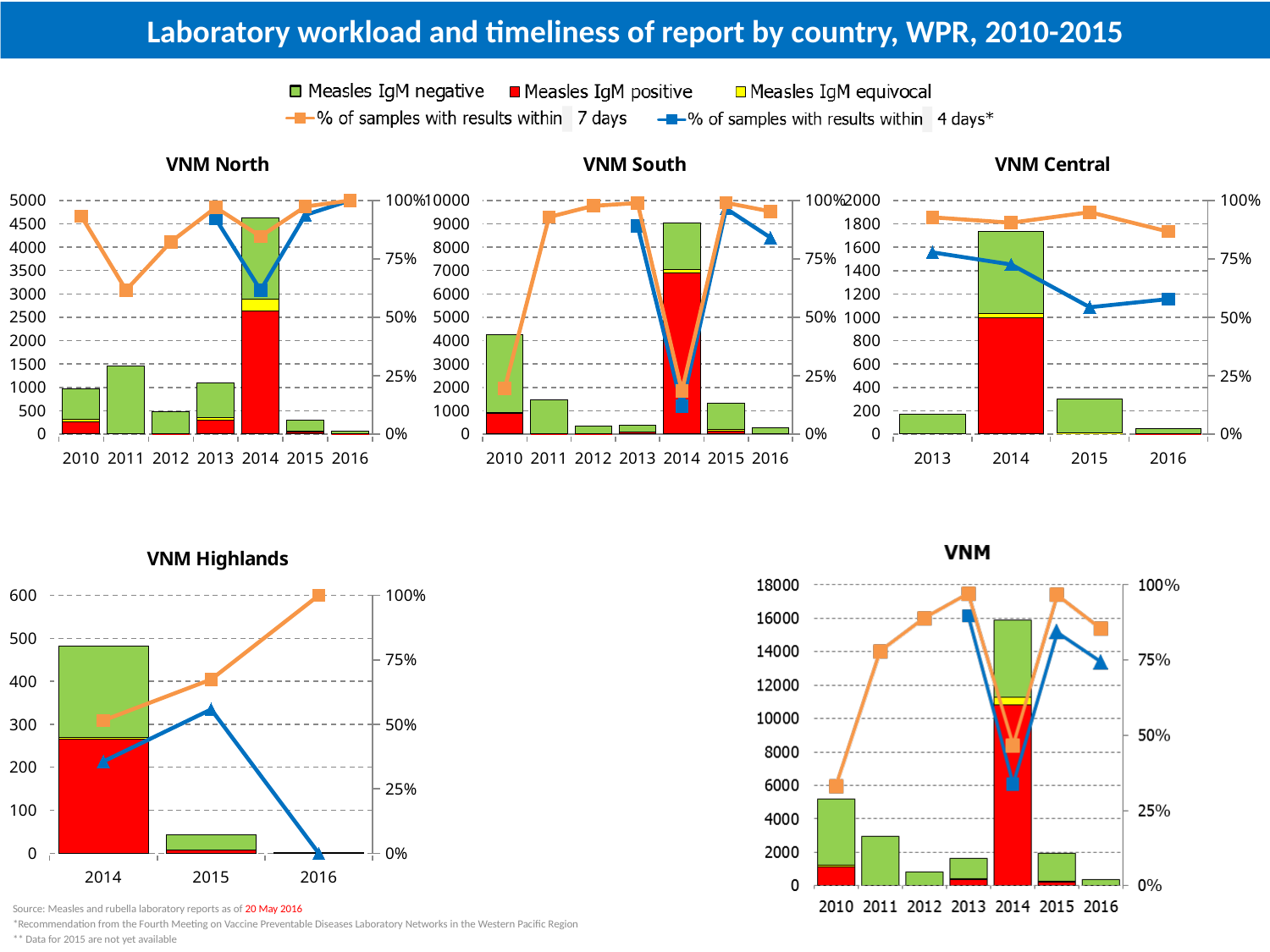
In the VNM chart (bottom right), is the total bar height for 2014 greater or less than 14000? greater In the VNM South chart, which year has the tallest stacked bar? 2014 In the VNM Central chart, how many years are shown on the x axis? 4 In the VNM North chart, which year has the tallest stacked bar? 2014 In the VNM South chart, is the stacked bar for 2010 taller or shorter than the bar for 2011? taller In the VNM Central chart, which year has the shortest stacked bar? 2016 How many charts are shown on the slide? 5 In the VNM North chart, is the total bar height for 2014 greater or less than 4000? greater In the VNM Highlands chart, does the '% of samples with results within 7 days' line rise or fall from 2014 to 2016? rise In the VNM North chart, how many years are shown on the x axis? 7 How many series does the shared legend at the top of the slide list? 5 In the VNM Highlands chart, what is the value of '% of samples with results within 7 days' for 2016? 100%